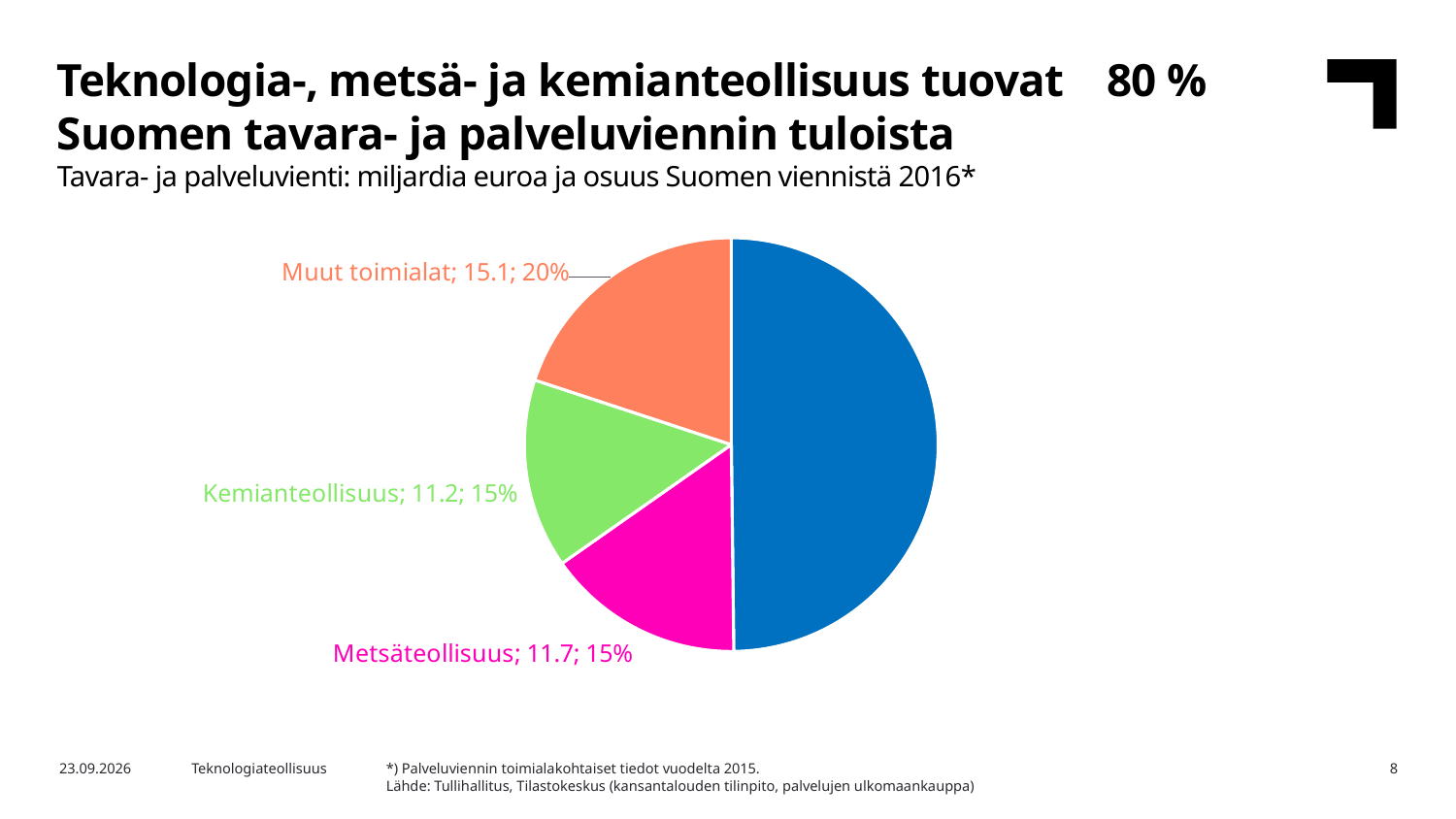
What is the difference in billions of euros between Muut toimialat and Kemianteollisuus? 3.9 What share of the pie does Muut toimialat represent? 20% What colour is the Kemianteollisuus slice? green What value in billions of euros is shown for Metsäteollisuus? 11.7 How many slices does the pie chart have? 4 What share of the pie does Metsäteollisuus represent? 15% Which is larger in billions of euros, Metsäteollisuus or Kemianteollisuus? Metsäteollisuus Among the three labelled slices, which has the largest value? Muut toimialat What is the difference in billions of euros between Metsäteollisuus and Kemianteollisuus? 0.5 What kind of chart is shown on the slide? pie chart What value in billions of euros is shown for Kemianteollisuus? 11.2 What value in billions of euros is shown for Muut toimialat? 15.1